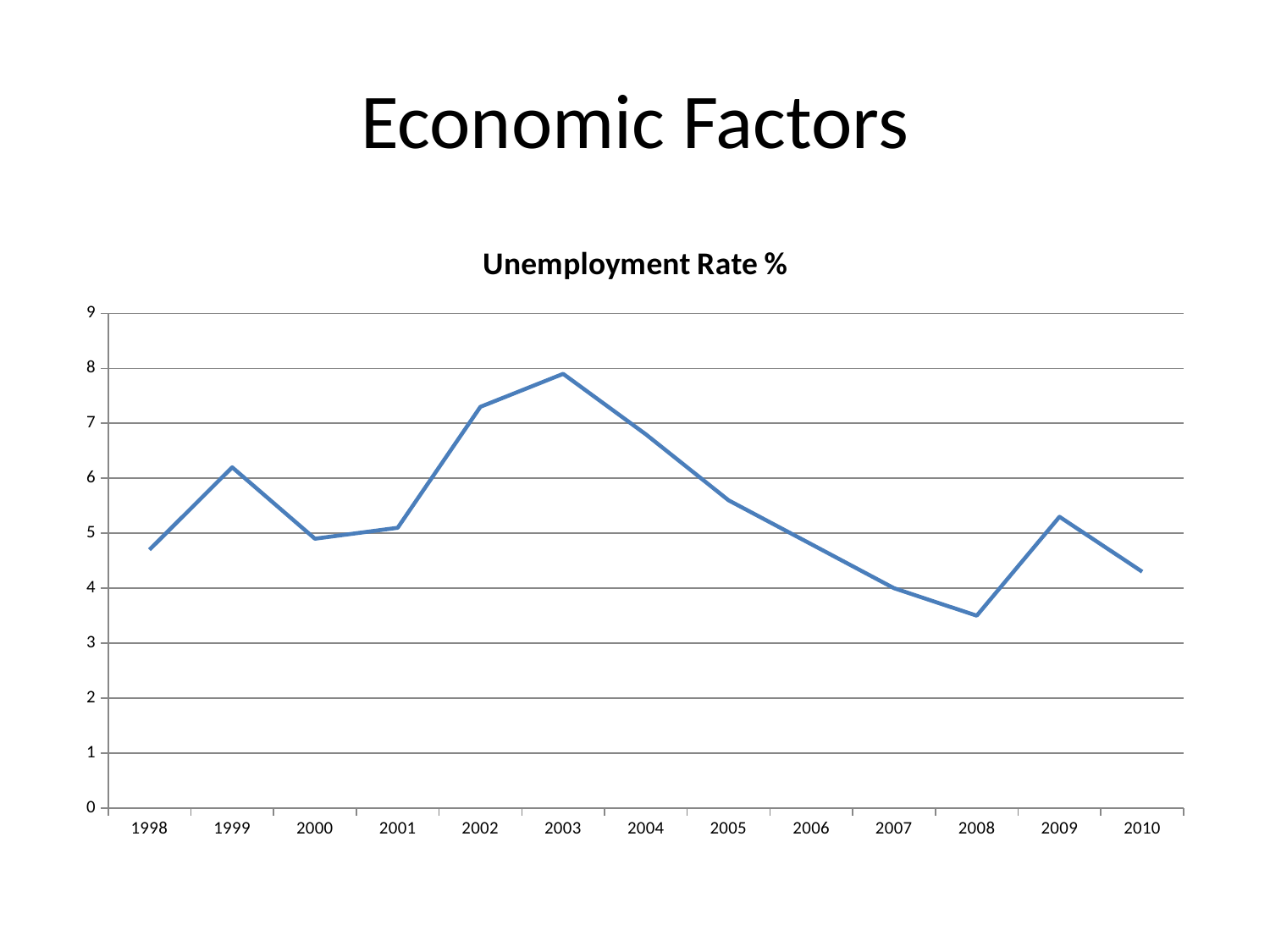
Which year has the highest unemployment rate in the chart? 2003 Is the unemployment rate for 1999 greater or less than 6? greater Which year has a higher unemployment rate, 2002 or 2005? 2002 Which year has a higher unemployment rate, 2009 or 2008? 2009 Is the unemployment rate for 2008 greater or less than 4? less Is the unemployment rate for 2010 greater or less than 5? less What is the title of the chart? Unemployment Rate % Which year has the lowest unemployment rate in the chart? 2008 What kind of chart is shown on the slide? line chart Does the unemployment rate rise or fall from 2003 to 2008? fall How many years are plotted on the x axis of the chart? 13